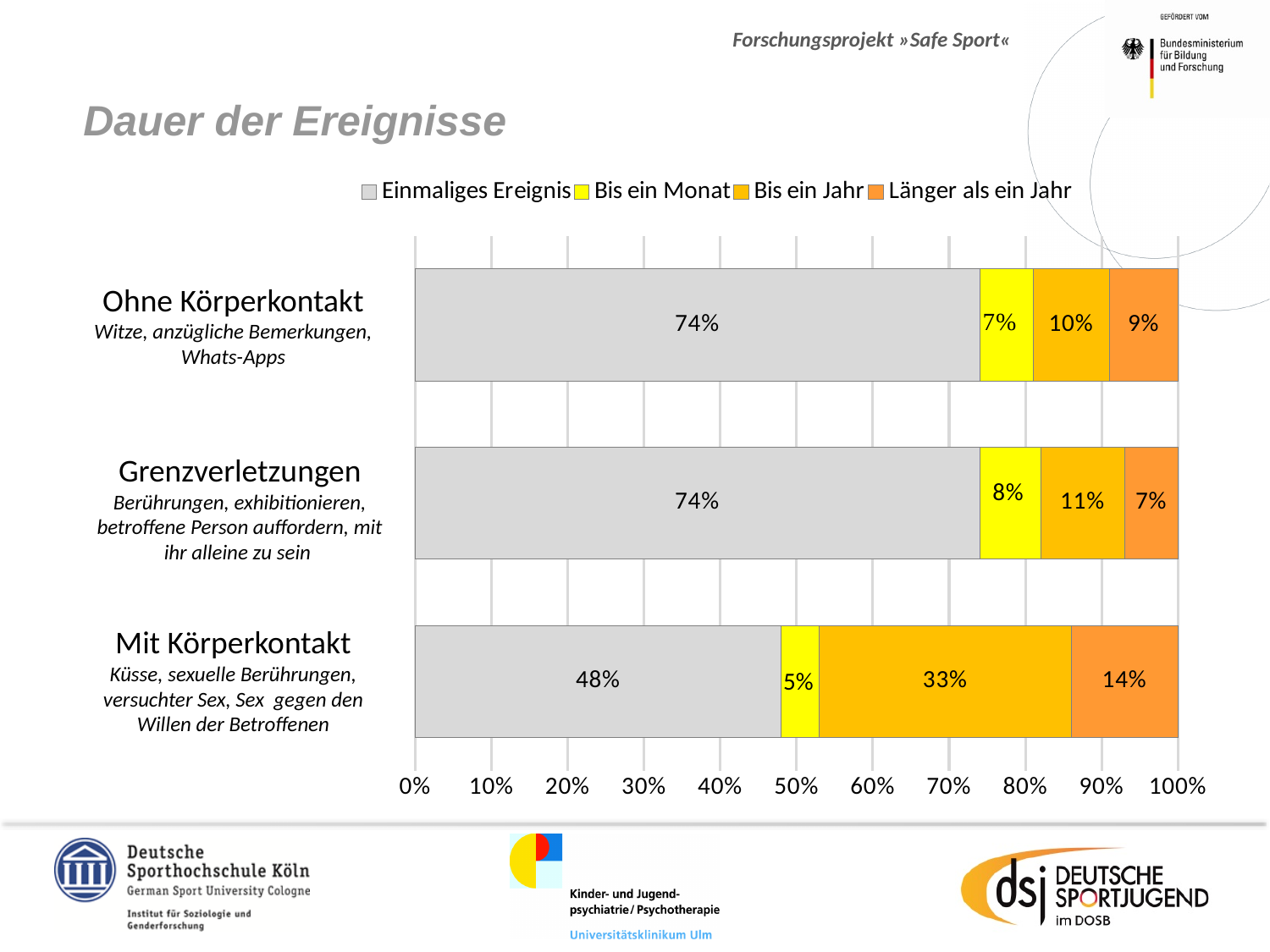
Which category has the lowest value for 'Einmaliges Ereignis'? Mit Körperkontakt What is the difference between the 'Bis ein Jahr' values for 'Mit Körperkontakt' and 'Ohne Körperkontakt'? 23% How many categories are shown on the chart? 3 What is the value of 'Bis ein Monat' for 'Grenzverletzungen'? 8% What kind of chart is shown on the slide? Stacked bar chart What is the value of 'Bis ein Jahr' for 'Mit Körperkontakt'? 33% Which category has the highest value for 'Länger als ein Jahr'? Mit Körperkontakt What is the value of 'Einmaliges Ereignis' for 'Mit Körperkontakt'? 48% Which is larger: 'Bis ein Jahr' for 'Grenzverletzungen' or 'Bis ein Jahr' for 'Ohne Körperkontakt'? Grenzverletzungen How many series does the legend list? 4 What is the title of the chart? Dauer der Ereignisse What is the value of 'Länger als ein Jahr' for 'Ohne Körperkontakt'? 9%